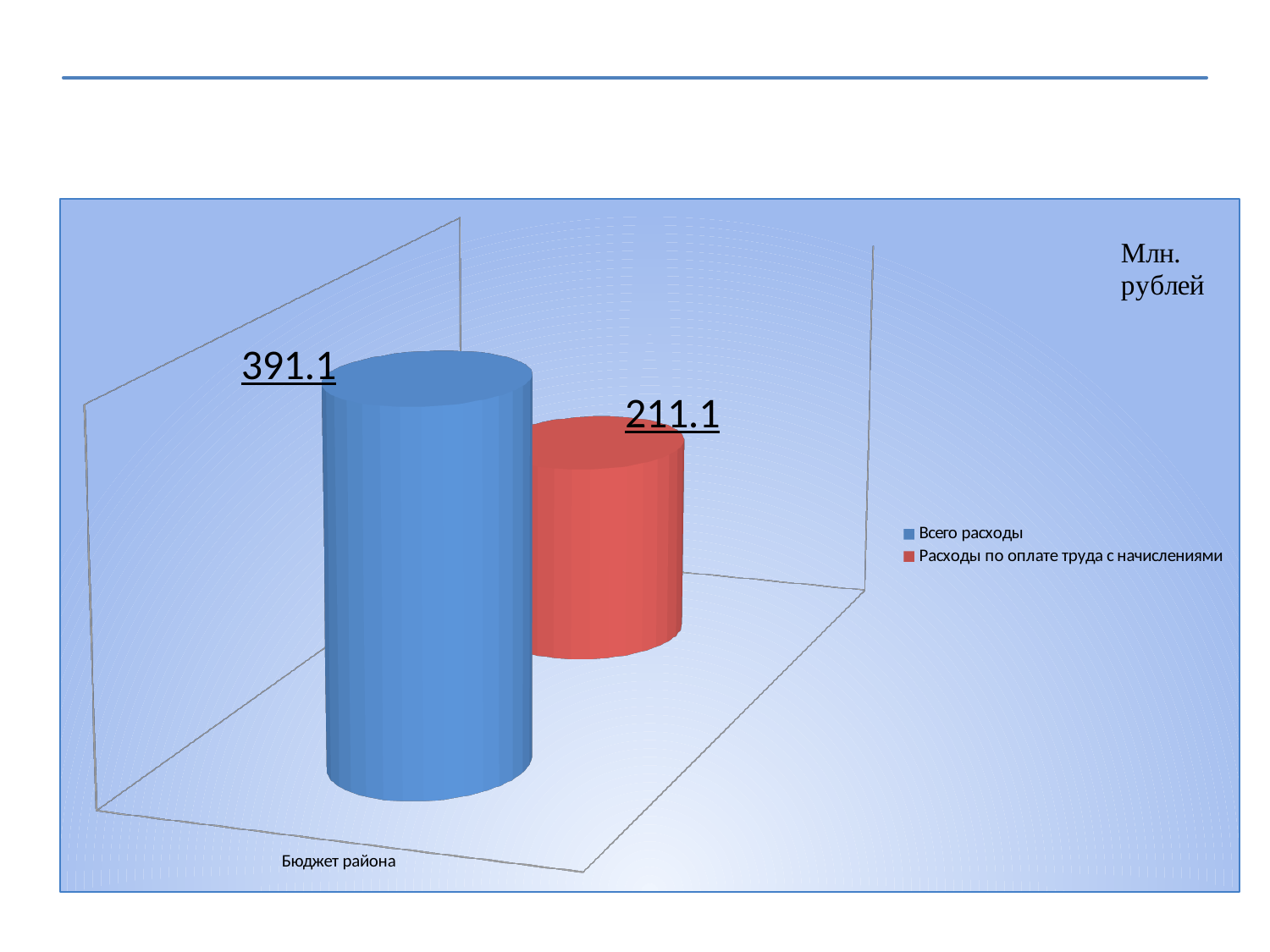
Which series has the lowest value on the chart? Расходы по оплате труда с начислениями What is the value for "Всего расходы" in the "Бюджет района" category? 391.1 How many categories are shown on the x axis? 1 What is the difference between "Всего расходы" and "Расходы по оплате труда с начислениями"? 180 What is the name of the category on the x axis? Бюджет района What is the value for "Расходы по оплате труда с начислениями"? 211.1 What unit is indicated in the top right corner of the chart? Млн. рублей Which series has the higher value: "Всего расходы" or "Расходы по оплате труда с начислениями"? Всего расходы How many series does the legend list? 2 What kind of chart is shown on the slide? Bar chart